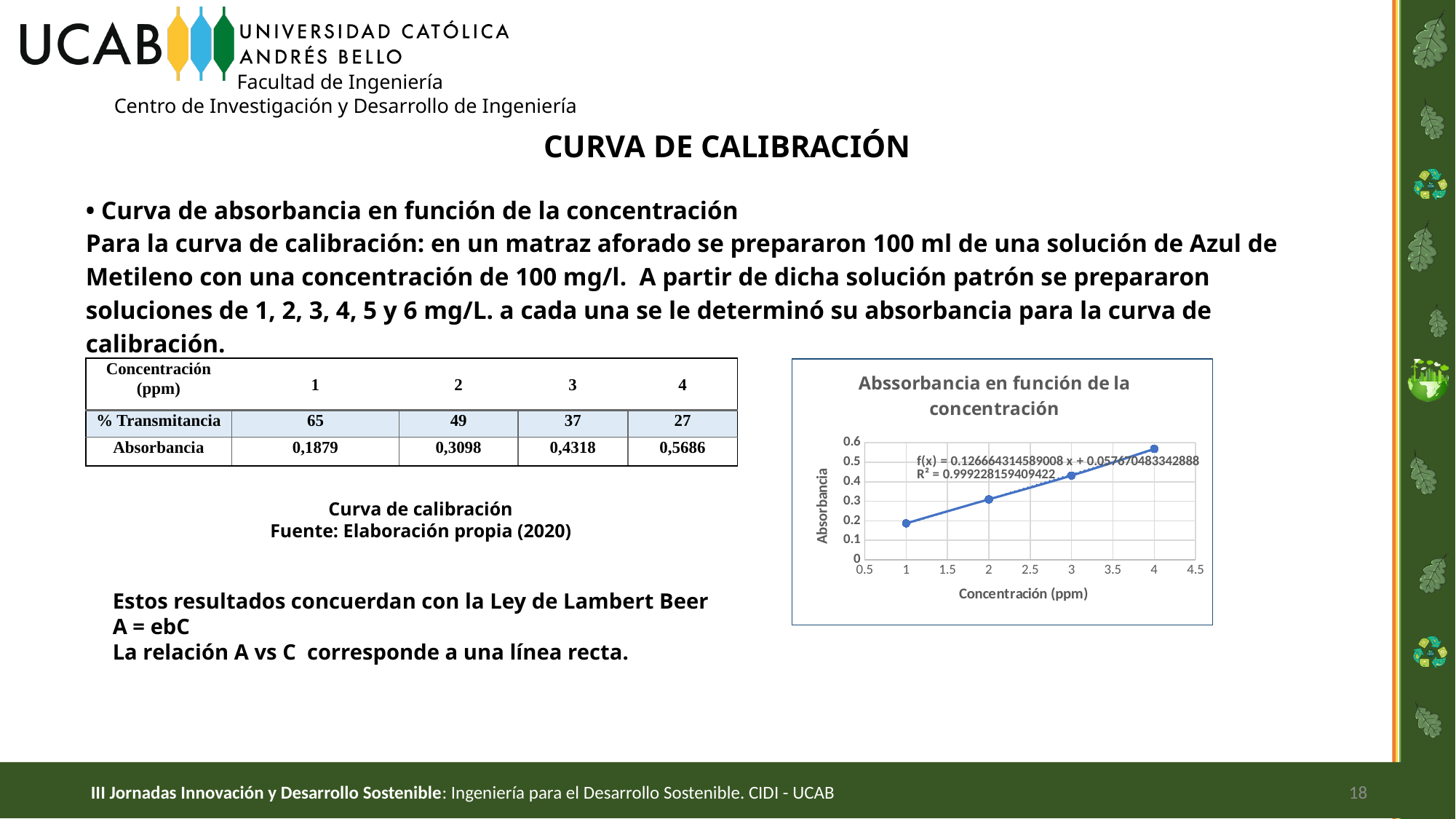
At which concentration (ppm) is the absorbance lowest? 1 What kind of chart is shown on the slide? Line chart (scatter with line) At which concentration (ppm) is the absorbance highest? 4 What is the title of the chart? Abssorbancia en función de la concentración What R² value is shown on the chart? 0.999228159409422 Which has the higher absorbance, 2 ppm or 3 ppm? 3 ppm How many data points are plotted on the chart? 4 Is the absorbance at 3 ppm greater or less than 0.5? less Does absorbance rise or fall as concentration increases along the x axis? Rises Is the absorbance at 4 ppm greater or less than 0.5? greater